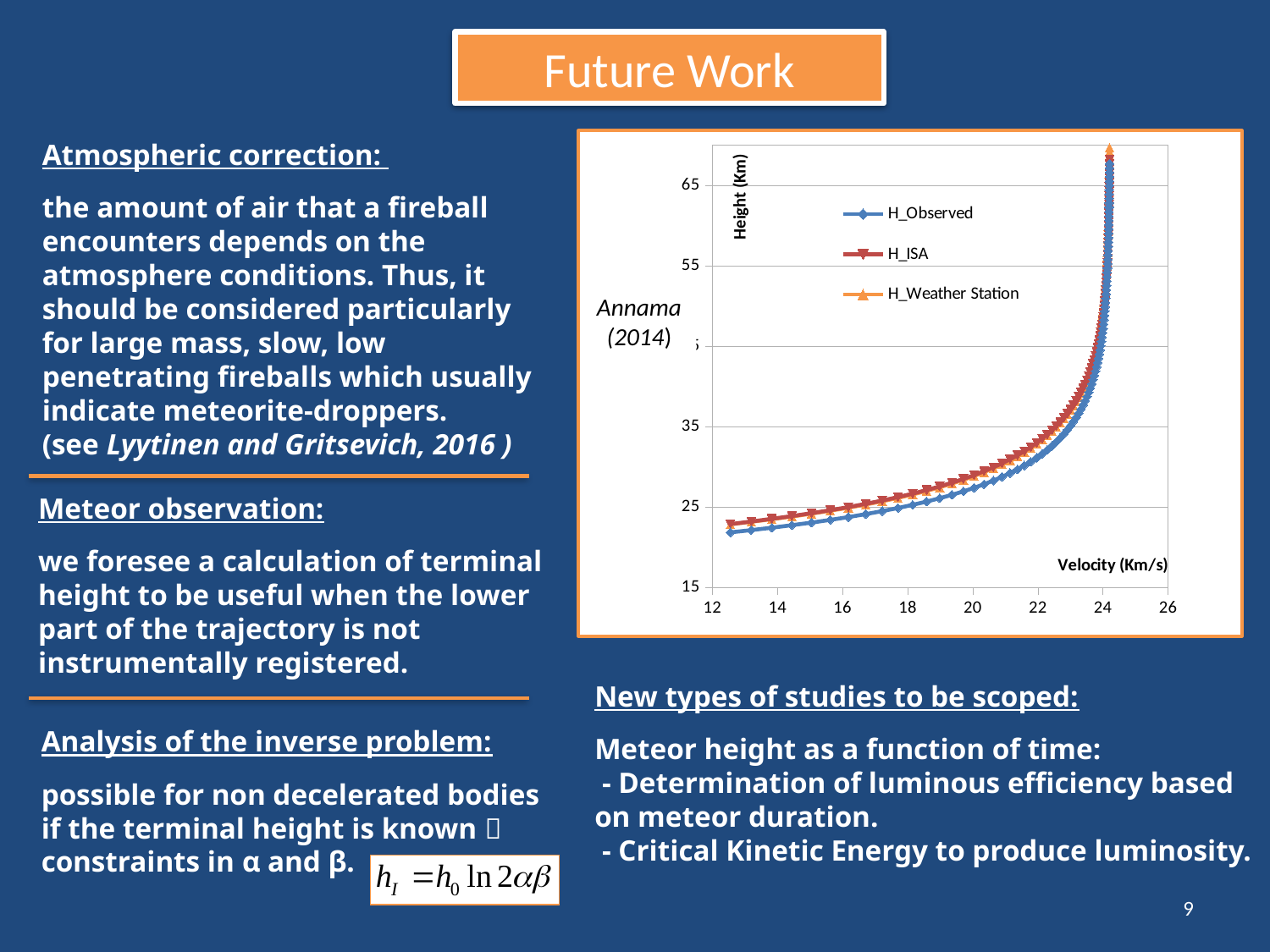
At the lowest plotted velocity, is the H_Observed height greater or less than 25? less Which series has the lowest height at the left end of the chart? H_Observed At a velocity of 20 Km/s, is the H_Observed height greater or less than 35? less Does height rise or fall as velocity increases along the x axis? rise What are the three series listed in the chart's legend? H_Observed, H_ISA, H_Weather Station How many series does the chart's legend list? 3 At a velocity of 16 Km/s, is the H_Weather Station height greater or less than 35? less At a velocity of 14 Km/s, which series shows the lower height, H_Observed or H_ISA? H_Observed What is the label of the chart's vertical axis? Height (Km) What kind of chart is shown on the slide? line chart